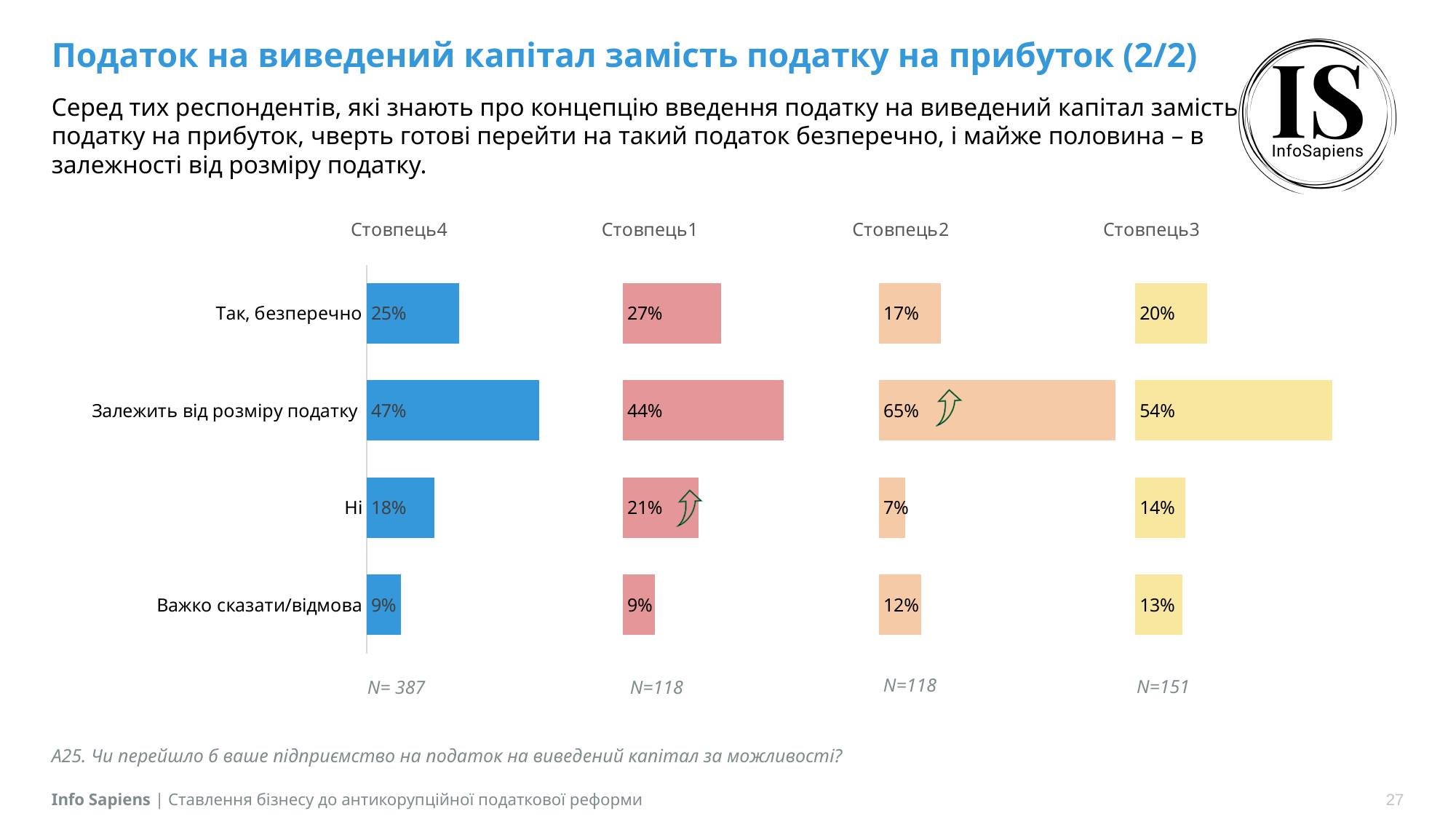
What is the value for "Ні" in the Стовпець3 series? 14% How many categories are shown on the chart? 4 What is the value for "Так, безперечно" in the Стовпець4 series? 25% Which is larger: the Стовпець1 value for "Ні" or the Стовпець4 value for "Ні"? Стовпець1 What colour are the bars of the Стовпець4 series? Blue Which category has the lowest value in the Стовпець2 series? Ні What is the value for "Залежить від розміру податку" in the Стовпець2 series? 65% What is the sample size (N) shown for the Стовпець3 series? N=151 How many series does the chart show? 4 What is the difference between the Стовпець2 and Стовпець1 values for "Залежить від розміру податку"? 21% Which category has the highest value in the Стовпець1 series? Залежить від розміру податку What kind of chart is shown on the slide? Bar chart